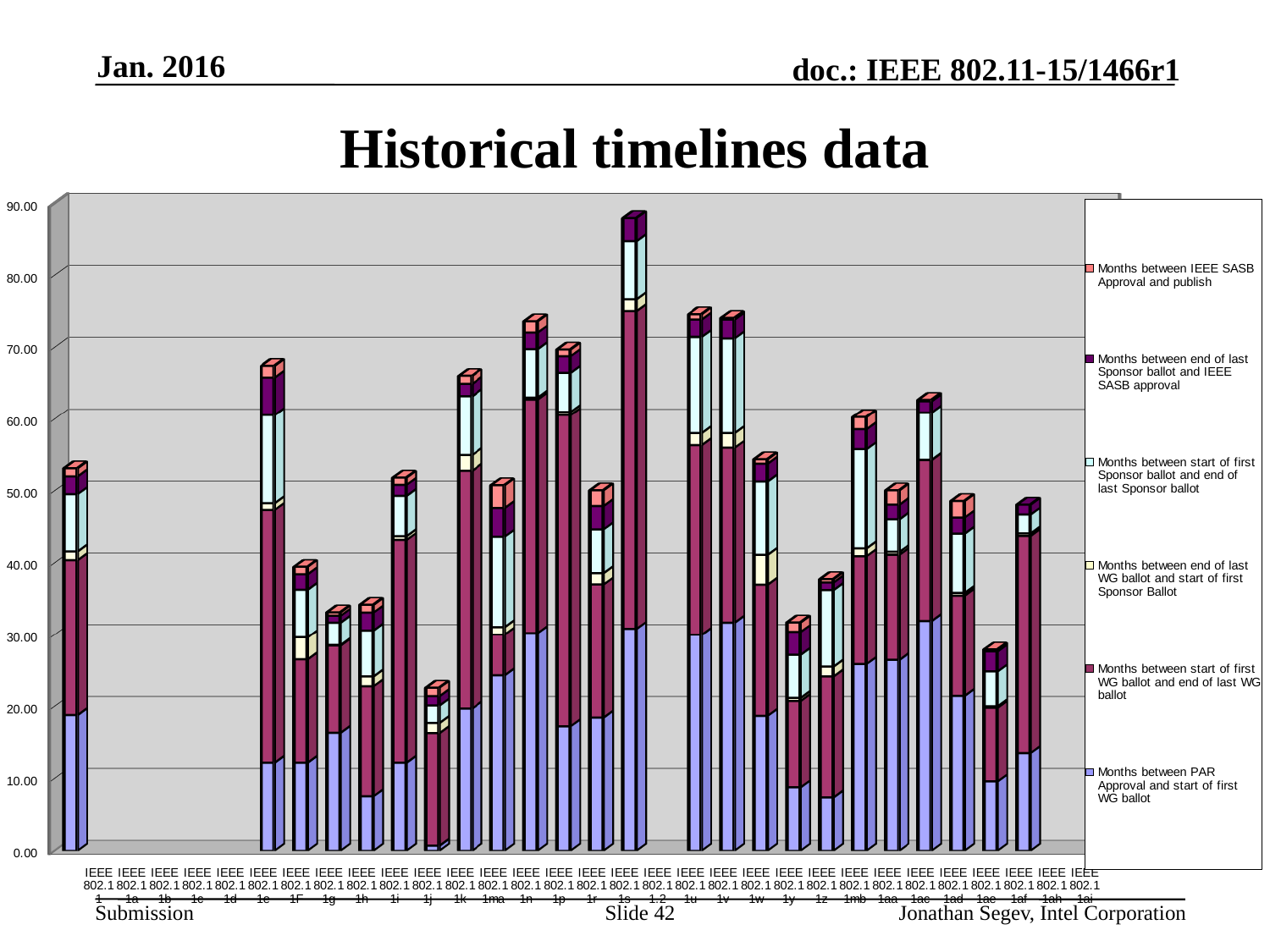
Is the total for IEEE 802.1 1e greater or less than 60? greater Which has the taller stacked bar, IEEE 802.1 1s or IEEE 802.1 1u? IEEE 802.11s Is the total for IEEE 802.1 1j greater or less than 30? less Which has the taller stacked bar, IEEE 802.1 1e or IEEE 802.1 1F? IEEE 802.11e Is the total for IEEE 802.1 1y greater or less than 40? less How many series does the legend list? 6 Which category has the tallest stacked bar? IEEE 802.11s Which series forms the bottom segment of each stacked bar? Months between PAR Approval and start of first WG ballot Which category has the shortest visible stacked bar? IEEE 802.11j What is the title of the chart? Historical timelines data What kind of chart is shown on the slide? Stacked bar chart